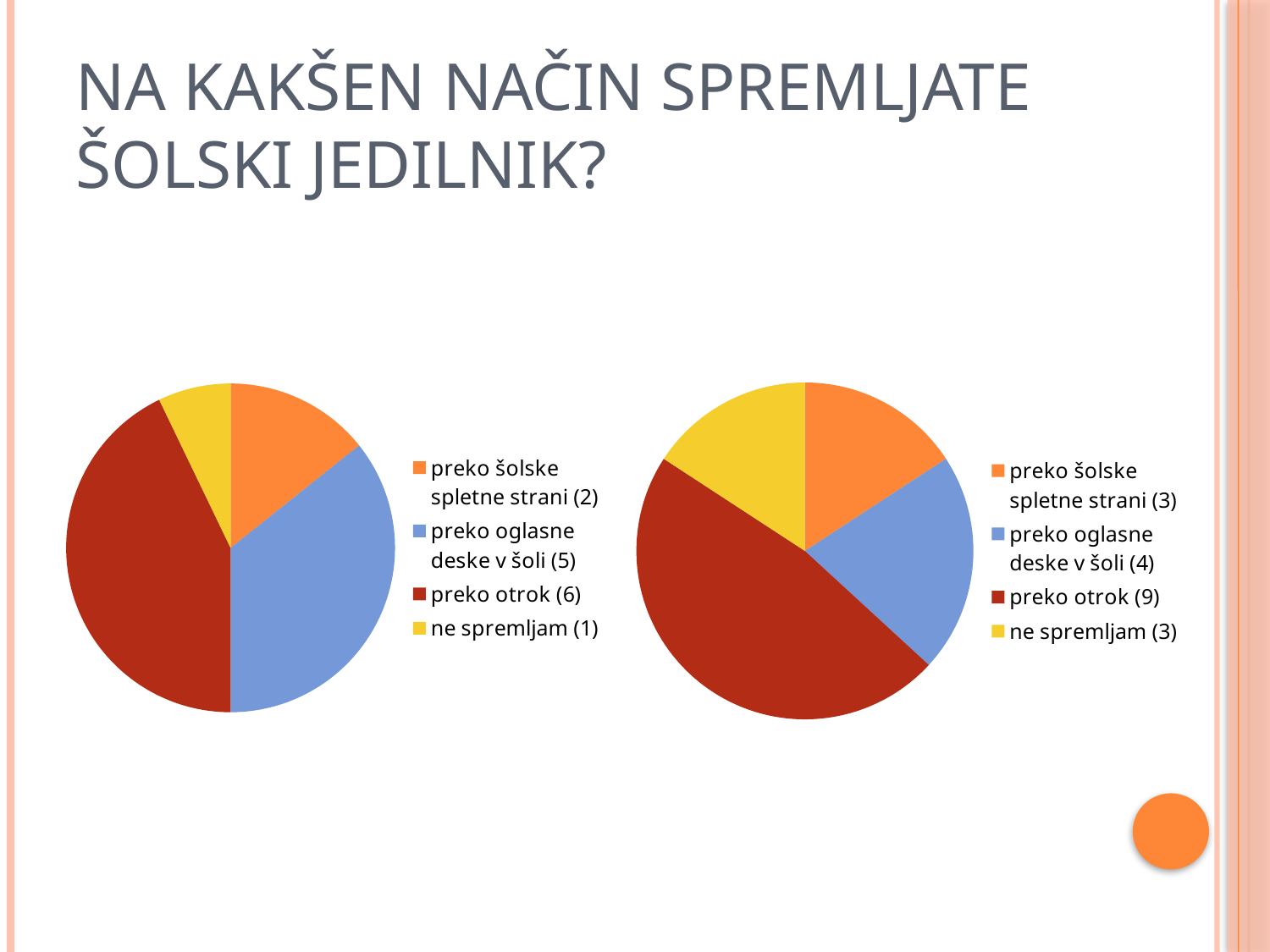
In the right pie chart, which is larger: "preko oglasne deske v šoli" or "preko šolske spletne strani"? preko oglasne deske v šoli In the left pie chart, how many respondents chose "preko oglasne deske v šoli"? 5 What type of chart is shown on the left of the slide? pie chart How many categories does the legend of the right pie chart list? 4 In the right pie chart, how many respondents chose "ne spremljam"? 3 In the left pie chart, what is the difference between "preko otrok" and "preko šolske spletne strani"? 4 What colour is the "preko otrok" slice in both pie charts? dark red In the left pie chart, which category has the largest slice? preko otrok In the left pie chart, which category has the smallest slice? ne spremljam In the left pie chart, how many respondents chose "preko otrok"? 6 In the right pie chart, how many respondents chose "preko otrok"? 9 In the right pie chart, which category has the largest slice? preko otrok